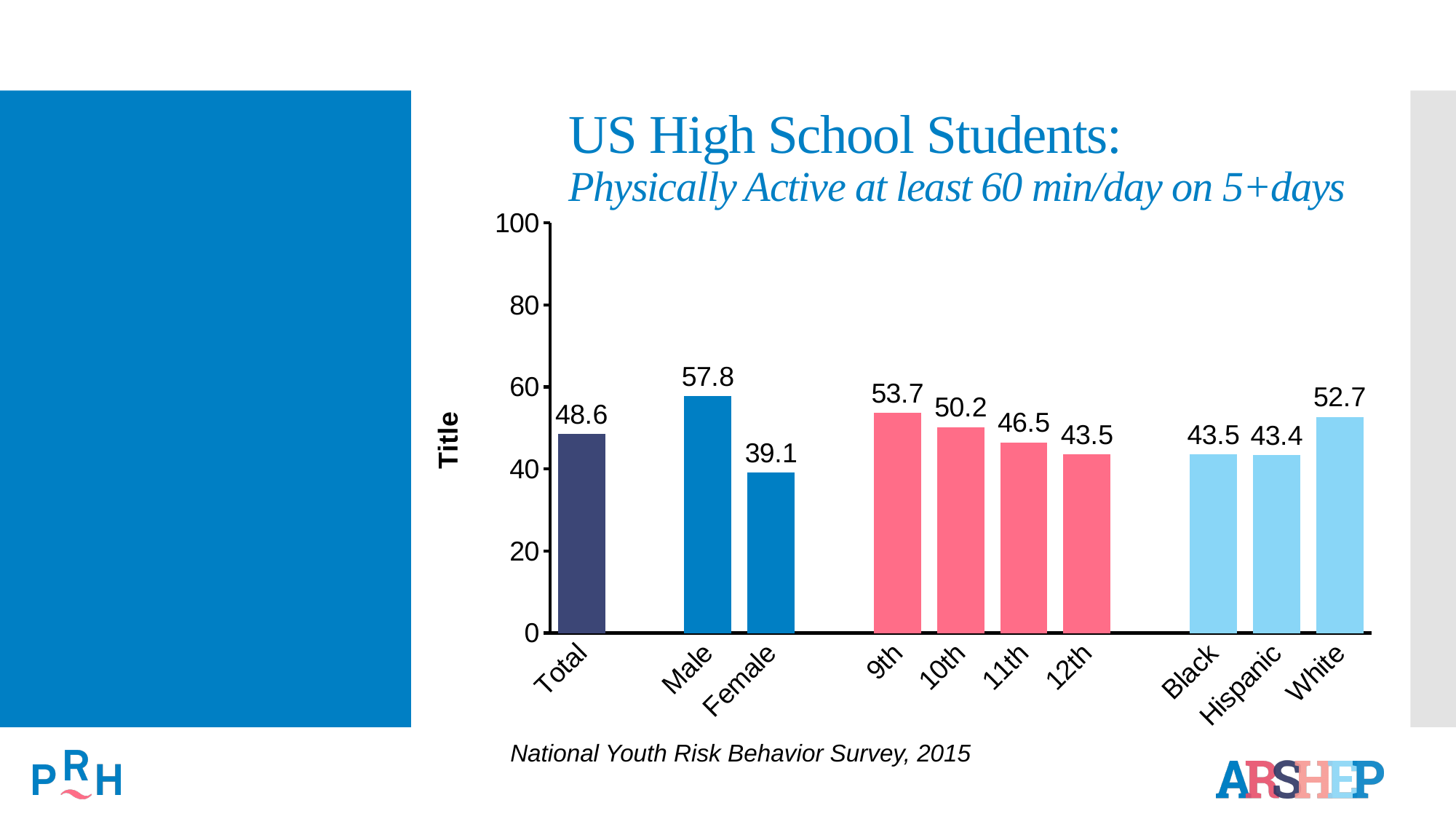
What is the value for Male? 57.8 What is the value for Total? 48.6 What is the difference between the values for Male and Female? 18.7 What kind of chart is this? bar chart Do the values rise or fall from 9th to 12th grade? fall Which is larger, the value for 9th or the value for 12th? 9th What is the value for White? 52.7 Which category has the lowest value? Female How many categories are shown on the x axis? 10 Is the value for Hispanic greater or less than 60? less Which category has the highest value? Male What is the value for Female? 39.1